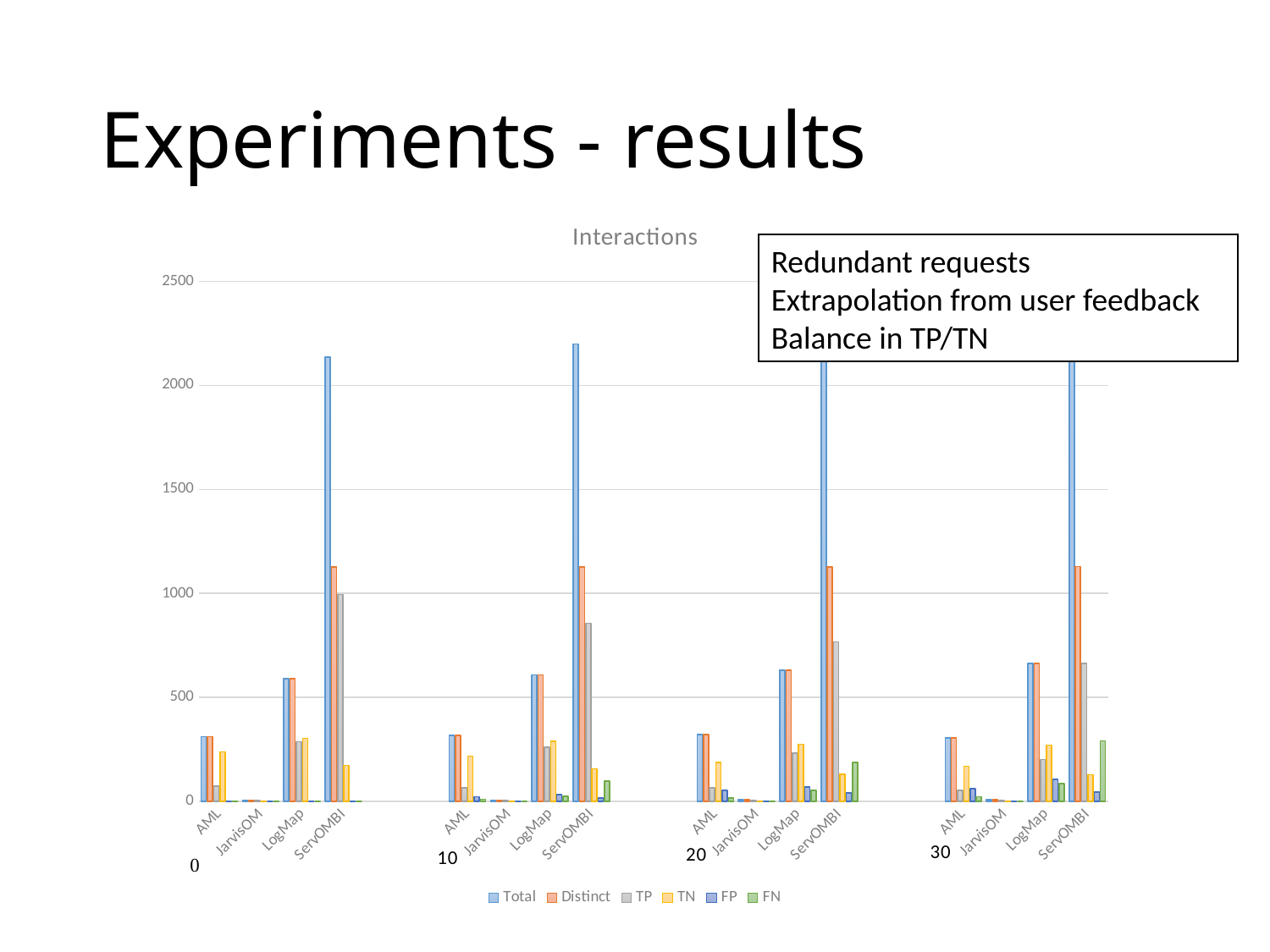
Is the Total value for AML in the group labelled 0 greater or less than 500? less How many groups (0, 10, 20, 30) are shown along the x axis? 4 Is the Distinct value for ServOMBI in the group labelled 0 greater or less than 1000? greater Which series are listed in the chart legend? Total, Distinct, TP, TN, FP, FN In the group labelled 0, which is larger: the Total for ServOMBI or the Total for LogMap? ServOMBI Which system has the highest Total bar in the group labelled 0? ServOMBI Is the Total value for ServOMBI in the group labelled 0 greater or less than 2000? greater What is the title of the chart? Interactions How many series does the legend list? 6 What kind of chart is shown on the slide? bar chart Which system has the lowest Total bar in the group labelled 0? JarvisOM